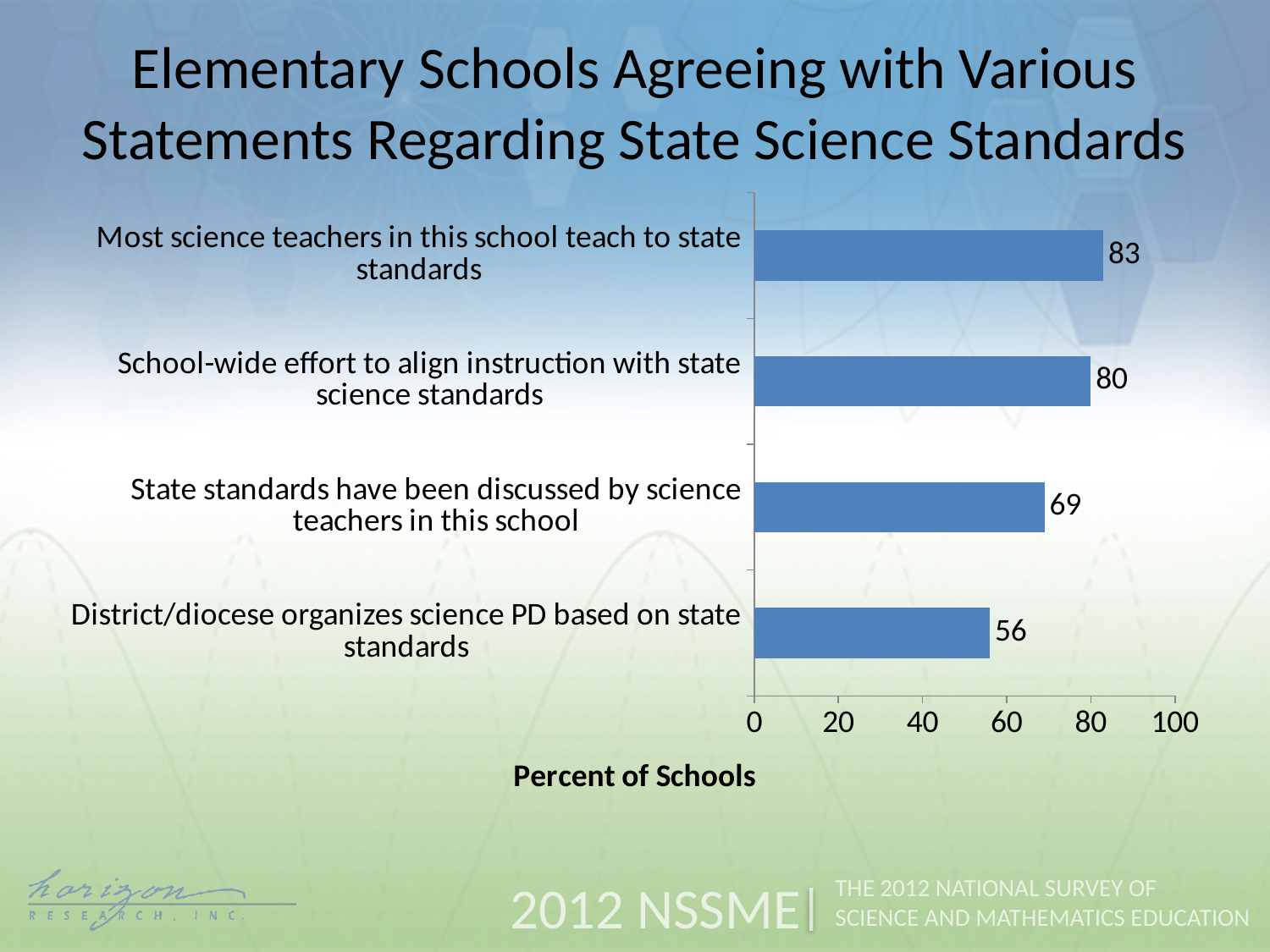
What is the difference in percent of schools between 'Most science teachers in this school teach to state standards' and 'District/diocese organizes science PD based on state standards'? 27 What percent of schools agree that most science teachers in this school teach to state standards? 83 Which statement has the highest percent of schools agreeing? Most science teachers in this school teach to state standards Which has a higher percent of schools agreeing: 'School-wide effort to align instruction with state science standards' or 'State standards have been discussed by science teachers in this school'? School-wide effort to align instruction with state science standards What percent of schools agree that state standards have been discussed by science teachers in this school? 69 What percent of schools agree that the district/diocese organizes science PD based on state standards? 56 What kind of chart is shown on the slide? Bar chart Which statement has the lowest percent of schools agreeing? District/diocese organizes science PD based on state standards Is the value for 'District/diocese organizes science PD based on state standards' greater or less than 60? less How many statements are shown in the chart? 4 What is the difference in percent of schools between 'School-wide effort to align instruction with state science standards' and 'State standards have been discussed by science teachers in this school'? 11 What is the label of the horizontal axis? Percent of Schools